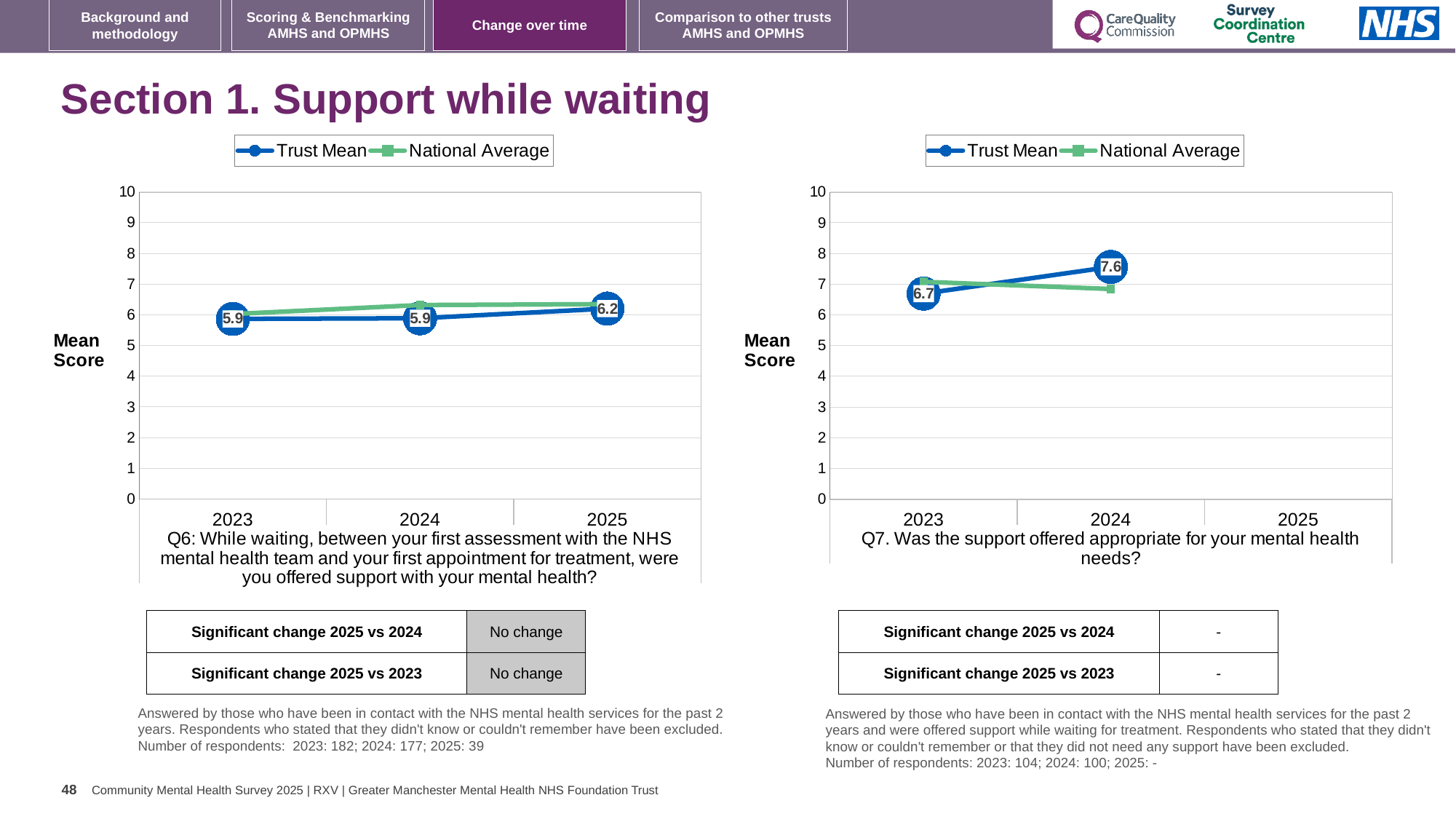
In the Q7 chart on the right, what is the difference between the Trust Mean for 2024 and 2023? 0.9 In the Q7 chart on the right, what is the Trust Mean score for 2024? 7.6 What type of chart is used for Q6 on the left? Line chart How many series does the legend of the Q7 chart on the right list? 2 In the Q6 chart on the left, which year has the highest Trust Mean? 2025 In the Q6 chart on the left, what is the Trust Mean score for 2025? 6.2 In the Q6 chart on the left, does the Trust Mean rise or fall from 2024 to 2025? Rise In the Q7 chart on the right, what is the Trust Mean score for 2023? 6.7 In the Q7 chart on the right, is the National Average for 2024 greater or less than 8? less In the Q6 chart on the left, by how much did the Trust Mean increase from 2024 to 2025? 0.3 In the Q7 chart on the right, which year has the higher Trust Mean, 2023 or 2024? 2024 In the Q6 chart on the left, what is the Trust Mean score for 2023? 5.9